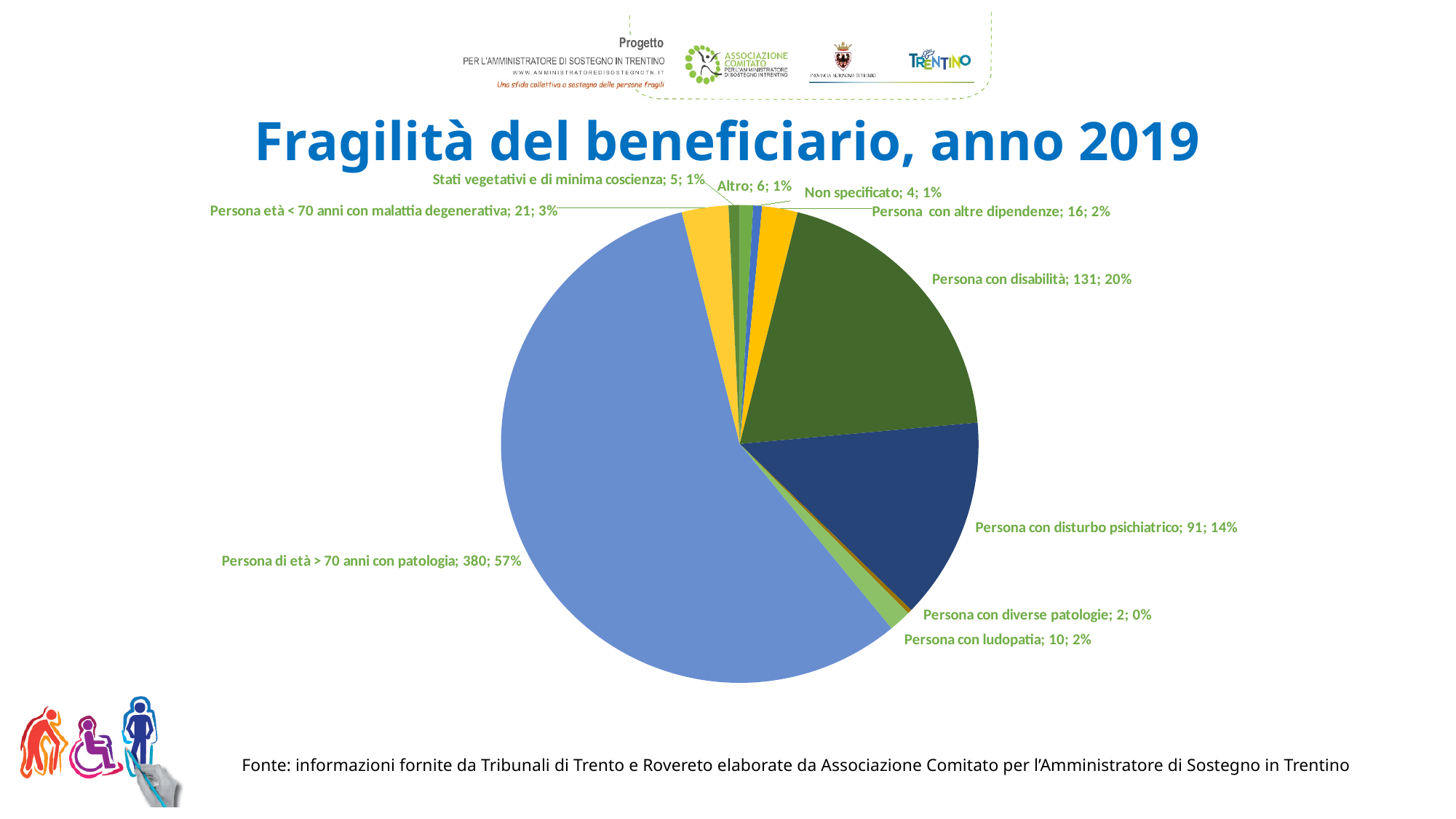
What kind of chart is shown on the slide? Pie chart What is the difference between the values for 'Persona con disabilità' and 'Persona con disturbo psichiatrico'? 40 What share of the pie does 'Persona con disabilità' represent? 20% How many categories (slices) does the pie chart have? 10 What is the value for 'Persona con disabilità'? 131 Which category has the largest slice of the pie? Persona di età > 70 anni con patologia What is the value for 'Persona con ludopatia'? 10 Which category has the smallest slice of the pie? Persona con diverse patologie What is the value for 'Persona con disturbo psichiatrico'? 91 What is the title of the chart on the slide? Fragilità del beneficiario, anno 2019 Which is larger: the value for 'Persona età < 70 anni con malattia degenerativa' or 'Persona con altre dipendenze'? Persona età < 70 anni con malattia degenerativa What share of the pie does 'Persona di età > 70 anni con patologia' represent? 57%